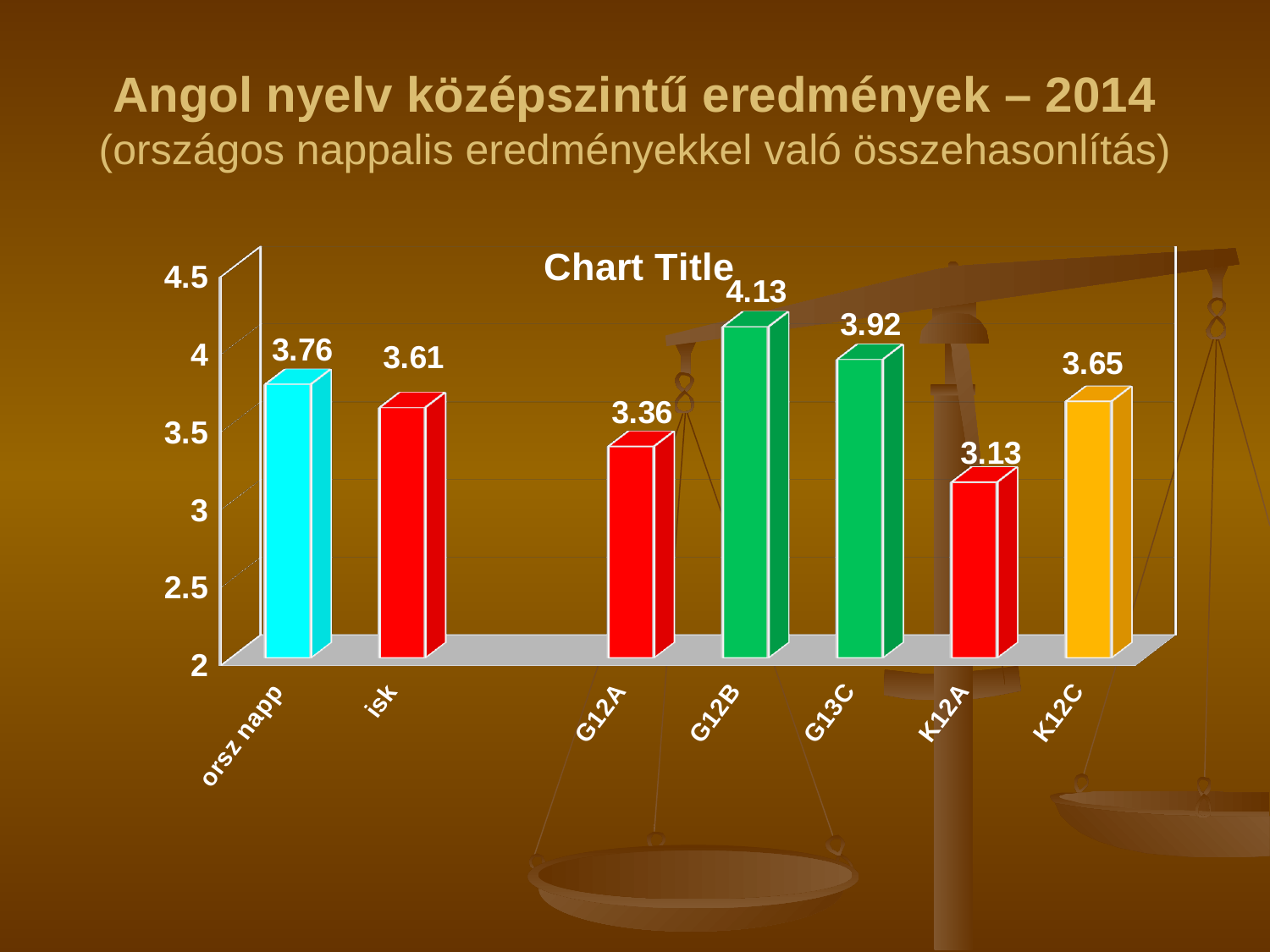
Which is larger, the value for G13C or the value for G12A? G13C What is the difference between the values for orsz napp and isk? 0.15 What is the value for orsz napp? 3.76 How many categories are shown on the x axis? 7 Which category has the lowest value? K12A What is the difference between the values for G12B and K12A? 1.00 What is the value for G12B? 4.13 What is the value for isk? 3.61 What kind of chart is shown on the slide? bar chart What is the value for K12C? 3.65 Which category has the highest value? G12B What is the title printed above the chart? Chart Title